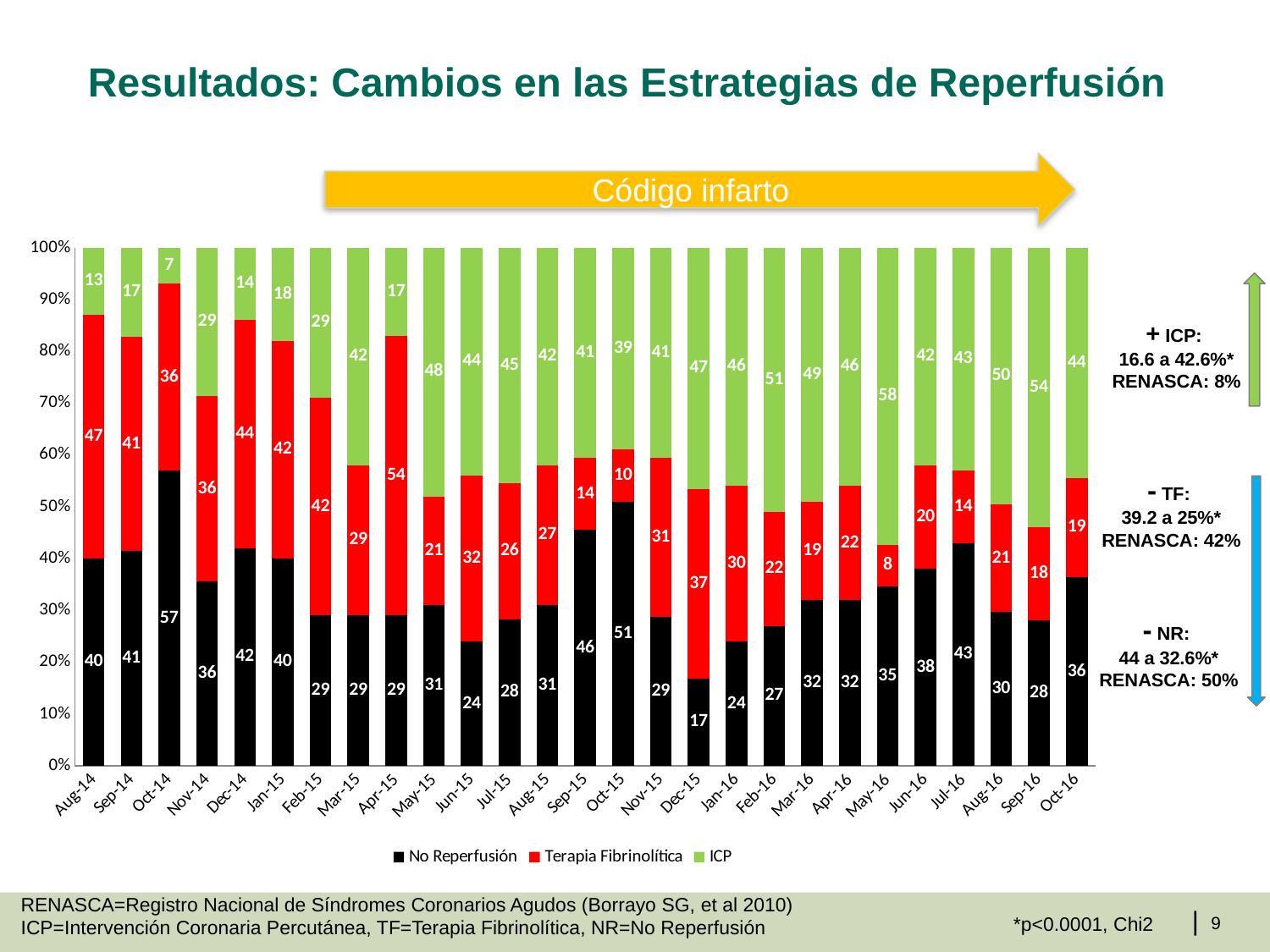
Which is larger, the Terapia Fibrinolítica value for Aug-14 or for Oct-16? Aug-14 Which month has the lowest No Reperfusión value? Dec-15 How many months are shown on the x axis? 27 What is the No Reperfusión value for Oct-14? 57 What is the Terapia Fibrinolítica value for Apr-15? 54 What is the difference between the ICP value for Oct-16 and the ICP value for Aug-14? 31 What type of chart is shown on the slide? Stacked bar chart Which month has the lowest ICP value? Oct-14 How many series does the legend list? 3 What is the ICP value for May-16? 58 Which month has the highest ICP value? May-16 Which series is shown in green in the legend? ICP